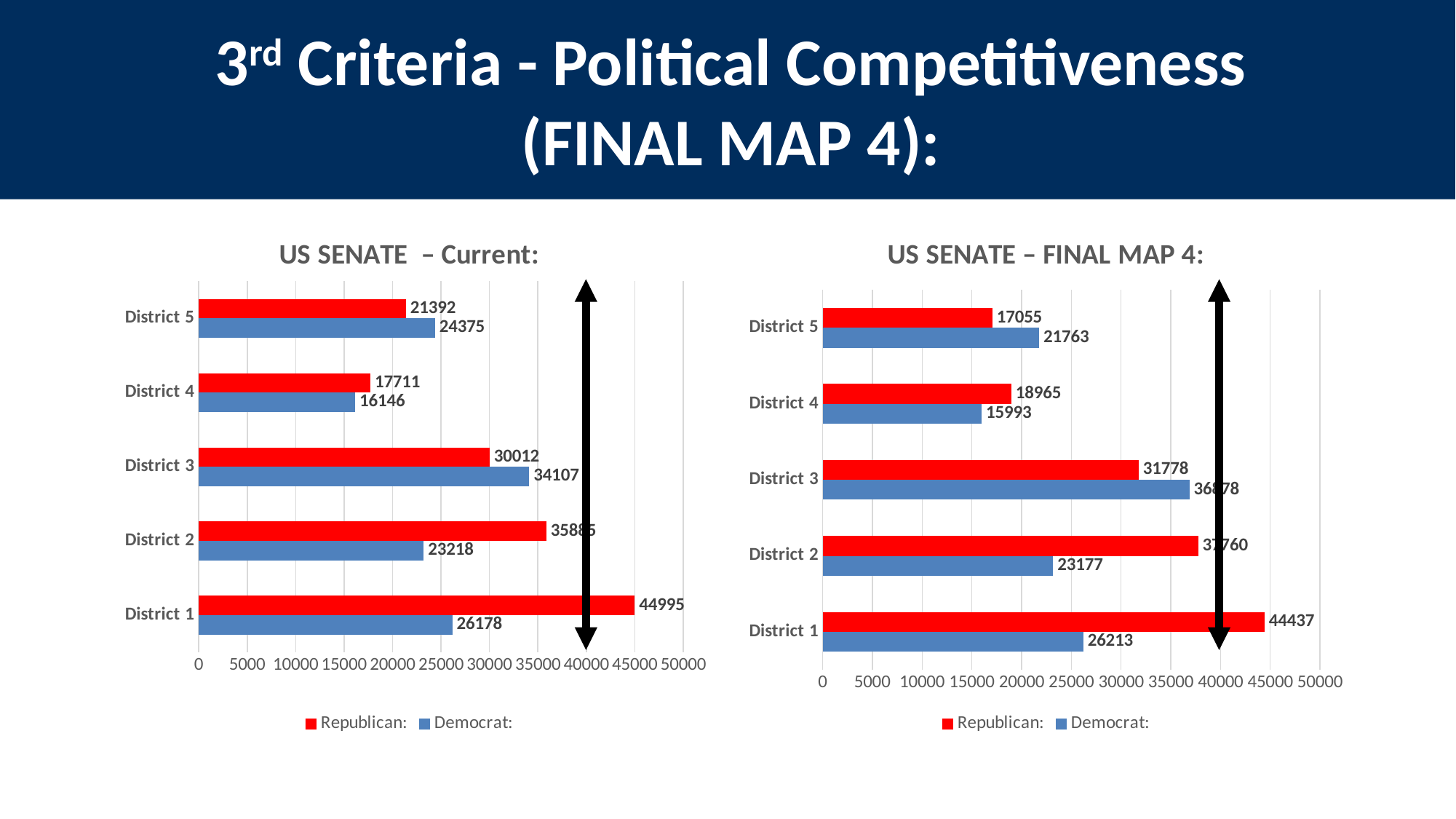
How many districts are shown in the US SENATE – FINAL MAP 4 chart? 5 In the US SENATE – Current chart, what is the Republican value for District 1? 44995 In the US SENATE – FINAL MAP 4 chart, which district has the lowest Democrat value? District 4 What type of chart is the US SENATE – FINAL MAP 4 chart? Bar chart How many series does the legend of the US SENATE – Current chart list? 2 In the US SENATE – Current chart, what is the difference between the Republican and Democrat values for District 1? 18817 In the US SENATE – Current chart, is the Democrat value for District 2 greater or less than 25000? less In the US SENATE – Current chart, what is the Democrat value for District 3? 34107 In the US SENATE – Current chart, which district has the highest Republican value? District 1 In the US SENATE – FINAL MAP 4 chart, what is the Democrat value for District 5? 21763 In the US SENATE – FINAL MAP 4 chart, which is larger for District 5, the Republican value or the Democrat value? Democrat In the US SENATE – FINAL MAP 4 chart, what is the Republican value for District 4? 18965